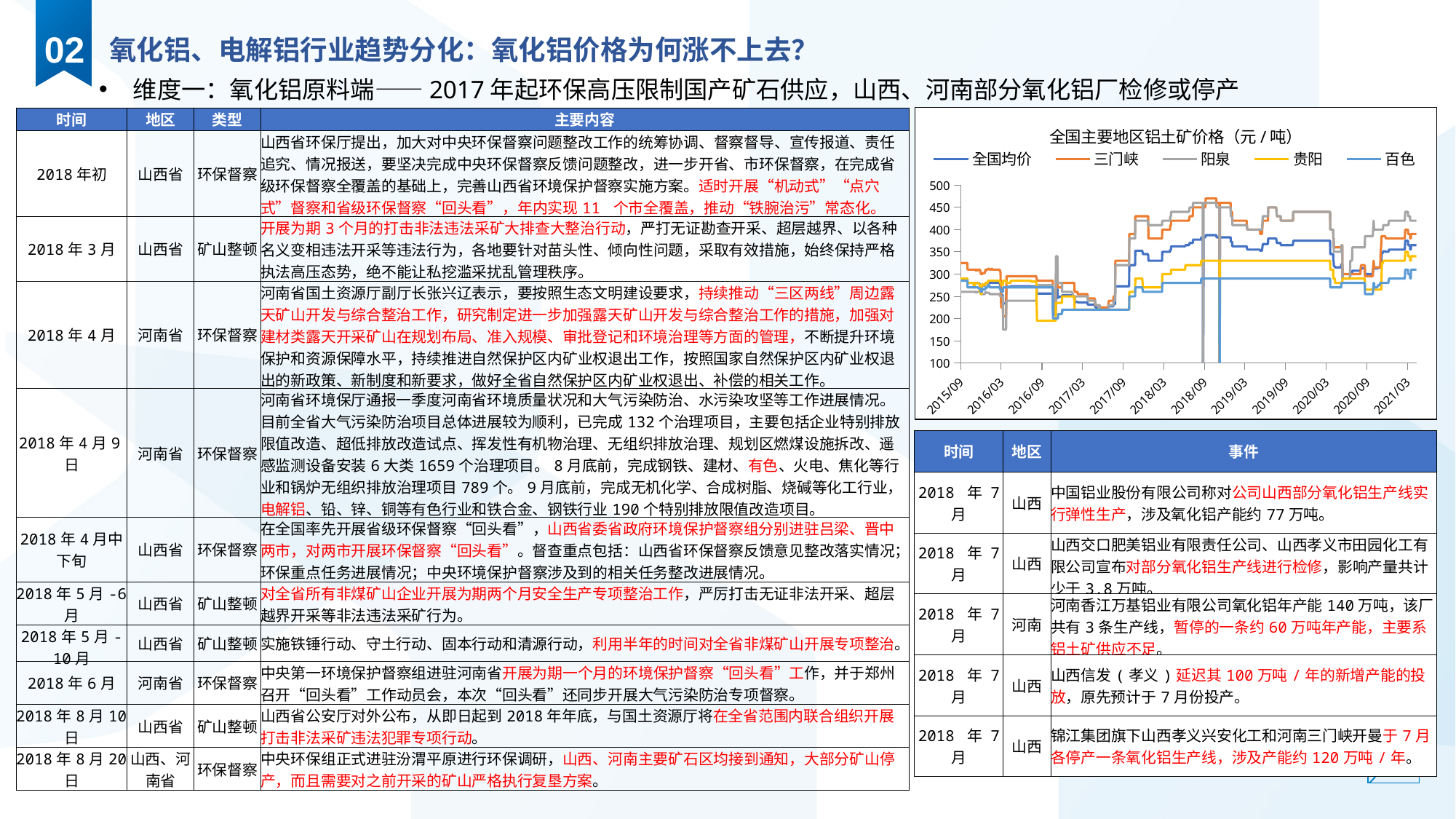
What are the lowest and highest values shown on the chart's y axis? 100 and 500 Is the value for 三门峡 at 2018/03 greater or less than 400? greater What is the title of the chart? 全国主要地区铝土矿价格（元/吨） At 2019/09, which is larger: the value for 阳泉 or the value for 百色? 阳泉 How many series does the legend of the chart list? 5 Is the value for 阳泉 at 2018/09 greater or less than 400? greater Is the value for 百色 at 2019/03 greater or less than 350? less What kind of chart is shown on the slide? line chart How many tick labels are shown on the chart's x axis? 12 Which series has the lowest value at 2019/03? 百色